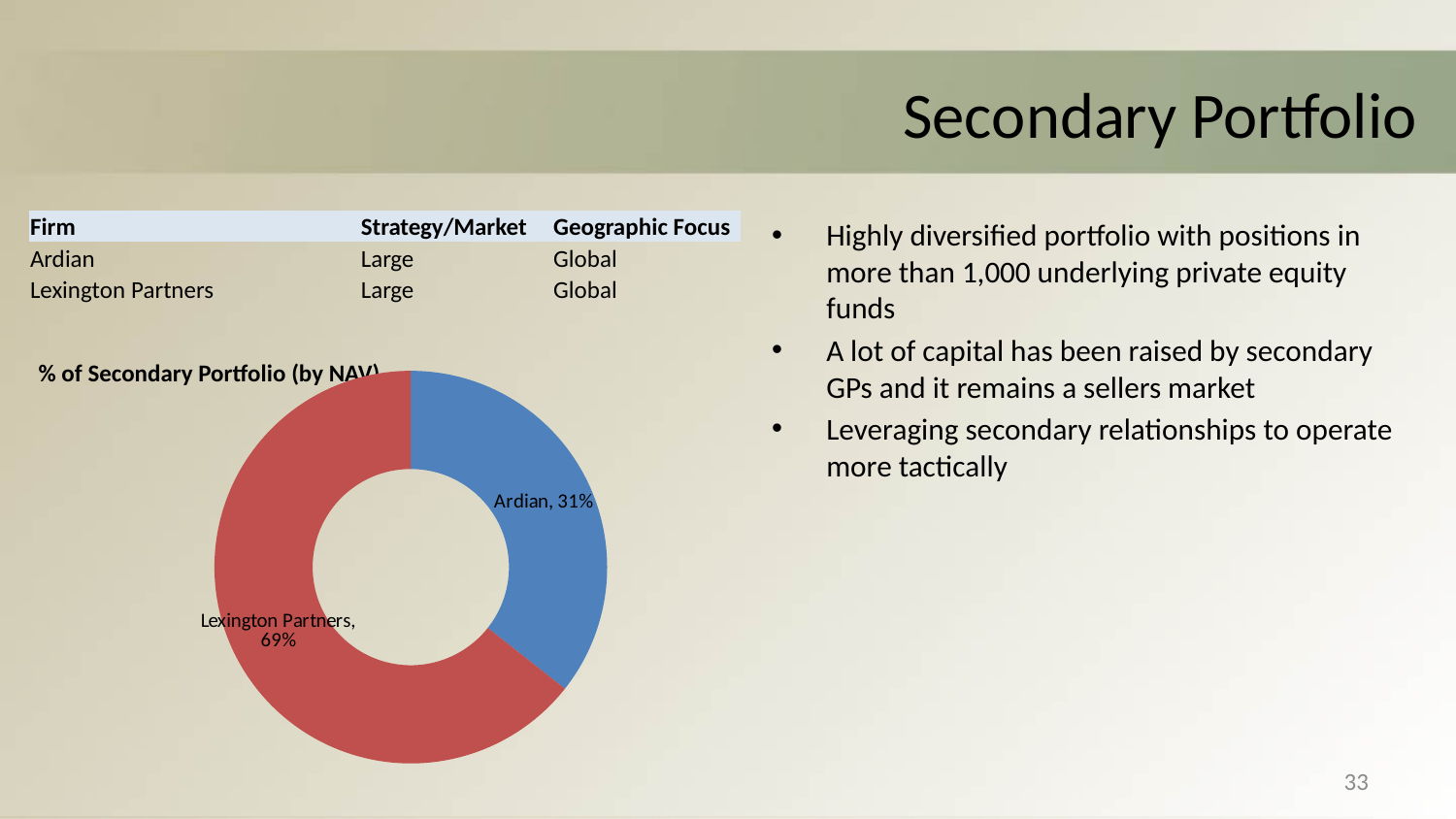
What is the title of the chart? % of Secondary Portfolio (by NAV) What share of the secondary portfolio does Lexington Partners hold? 69% What share of the secondary portfolio does Ardian hold? 31% What is the difference in percentage points between Lexington Partners' share and Ardian's share? 38 What colour is the Ardian slice in the chart? Blue Which firm has the smallest share of the secondary portfolio? Ardian How many firms are shown in the chart? 2 Which firm has the largest share of the secondary portfolio? Lexington Partners What kind of chart is used to show the secondary portfolio breakdown? Doughnut (pie) chart What is the combined share of Ardian and Lexington Partners in the chart? 100% Which is larger, Ardian's share or Lexington Partners' share of the secondary portfolio? Lexington Partners